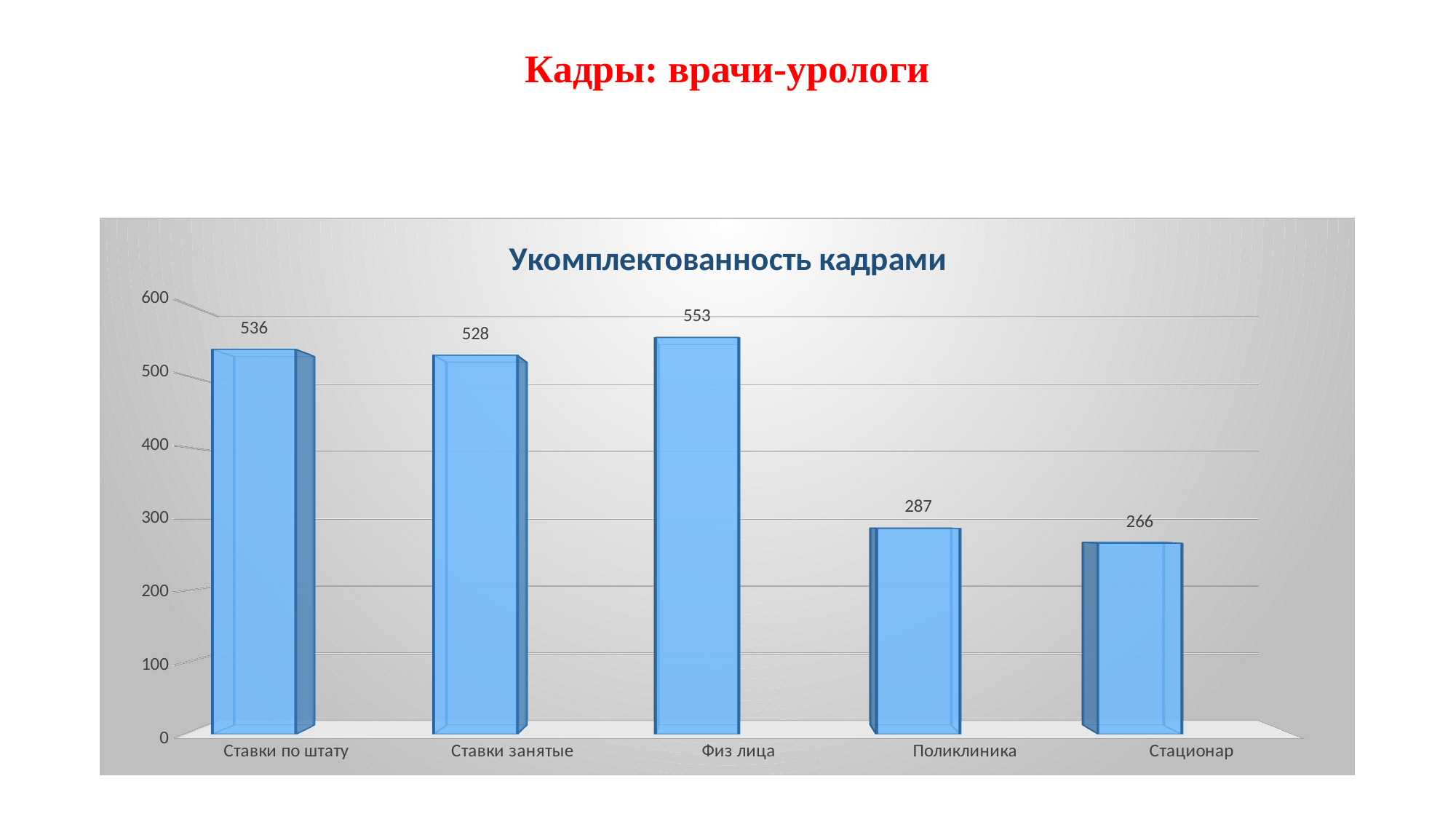
Which category has the highest value? Физ лица How many categories are shown on the chart? 5 What is the value for Стационар? 266 What is the value for Ставки по штату? 536 What is the value for Физ лица? 553 What is the difference between the values for Ставки по штату and Ставки занятые? 8 What is the difference between the values for Поликлиника and Стационар? 21 What is the value for Поликлиника? 287 Which is larger, the value for Физ лица or the value for Поликлиника? Физ лица Which category has the lowest value? Стационар What is the title of the chart? Укомплектованность кадрами What is the value for Ставки занятые? 528